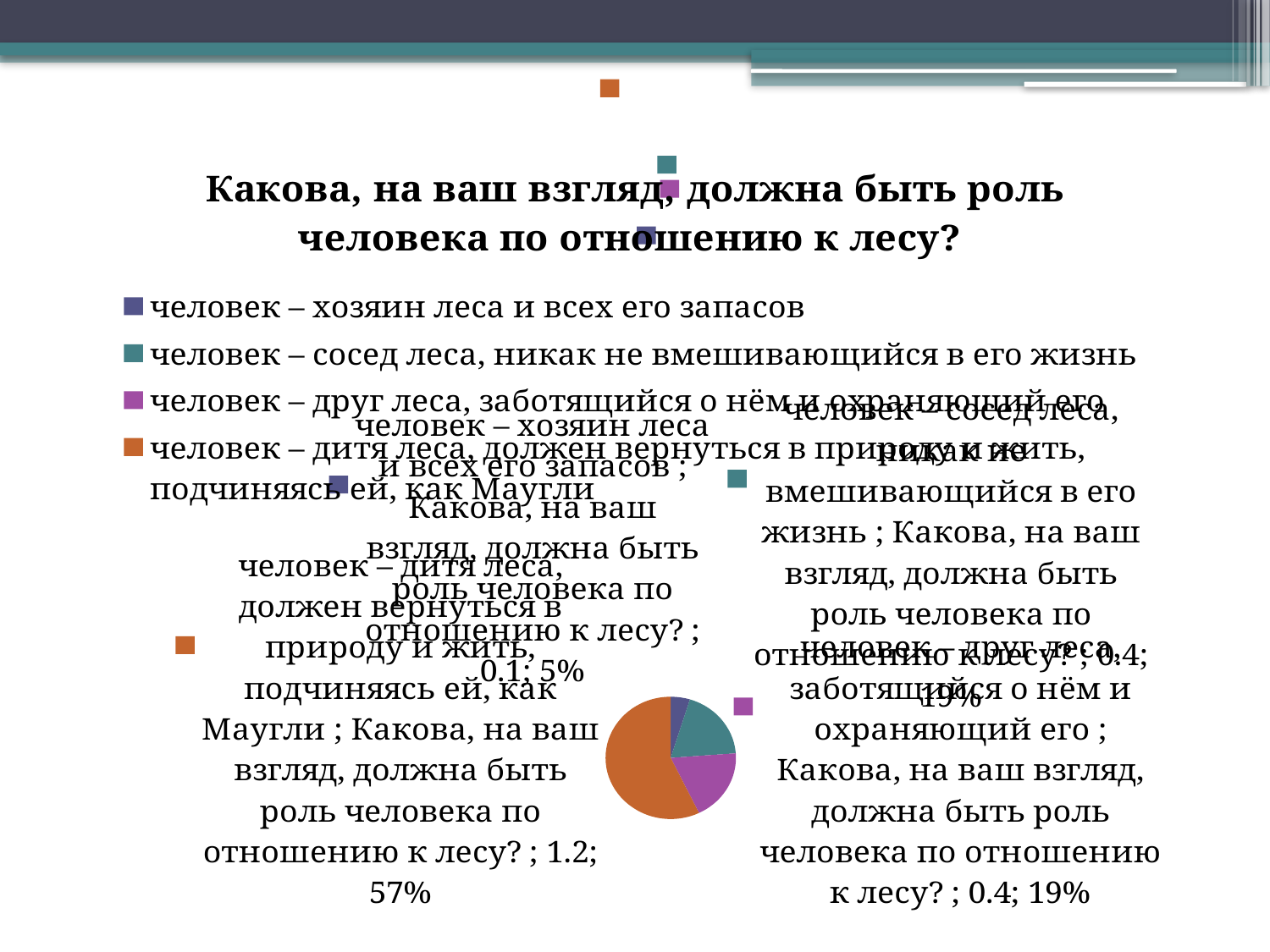
What value is printed for 'человек – дитя леса, должен вернуться в природу и жить, подчиняясь ей, как Маугли'? 1.2 What percentage share is shown for 'человек – хозяин леса и всех его запасов'? 5% What kind of chart is shown on the slide? pie chart Which category has the smallest share of the pie? человек – хозяин леса и всех его запасов Which category has the largest share of the pie? человек – дитя леса, должен вернуться в природу и жить, подчиняясь ей, как Маугли What percentage share is shown for 'человек – сосед леса, никак не вмешивающийся в его жизнь'? 19% By how many percentage points does the share of 'человек – дитя леса' exceed the share of 'человек – хозяин леса и всех его запасов'? 52% What is the title of the chart? Какова, на ваш взгляд, должна быть роль человека по отношению к лесу? How many slices does the pie chart have? 4 What percentage share is shown for 'человек – дитя леса, должен вернуться в природу и жить, подчиняясь ей, как Маугли'? 57% What value is printed for 'человек – хозяин леса и всех его запасов'? 0.1 How many entries does the chart's legend list? 4